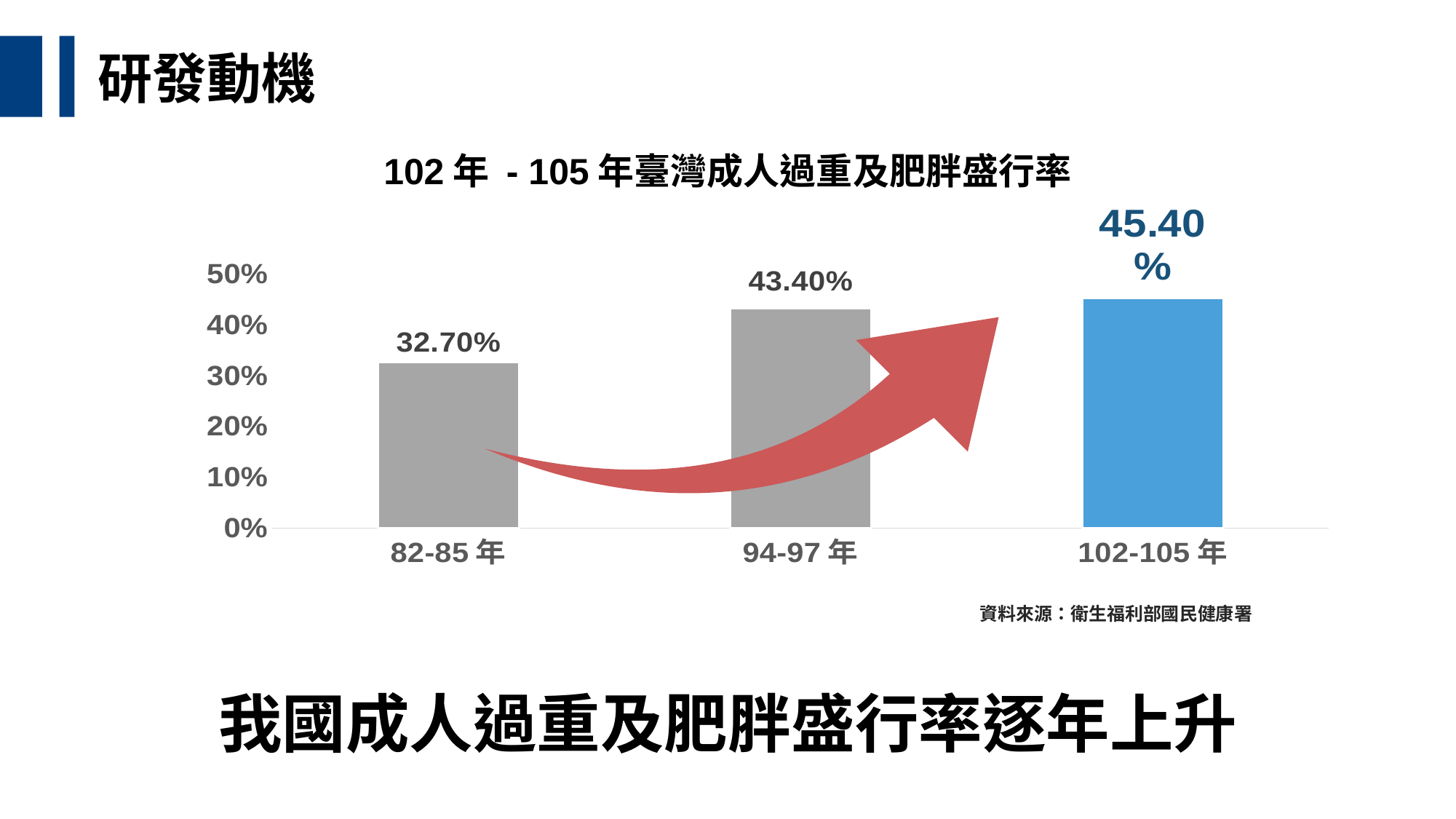
Which is larger, the value for 94-97 年 or the value for 82-85 年? 94-97 年 What is the value for 94-97 年? 43.40% What is the difference between the values for 102-105 年 and 82-85 年? 12.70% How many periods are shown on the x axis? 3 Do the values rise or fall from 82-85 年 to 102-105 年? rise Is the value for 82-85 年 greater or less than 40%? less What is the difference between the values for 94-97 年 and 82-85 年? 10.70% What is the value for 102-105 年? 45.40% What is the value for 82-85 年? 32.70% Which period has the highest value? 102-105 年 What kind of chart is shown on the slide? bar chart Which period has the lowest value? 82-85 年